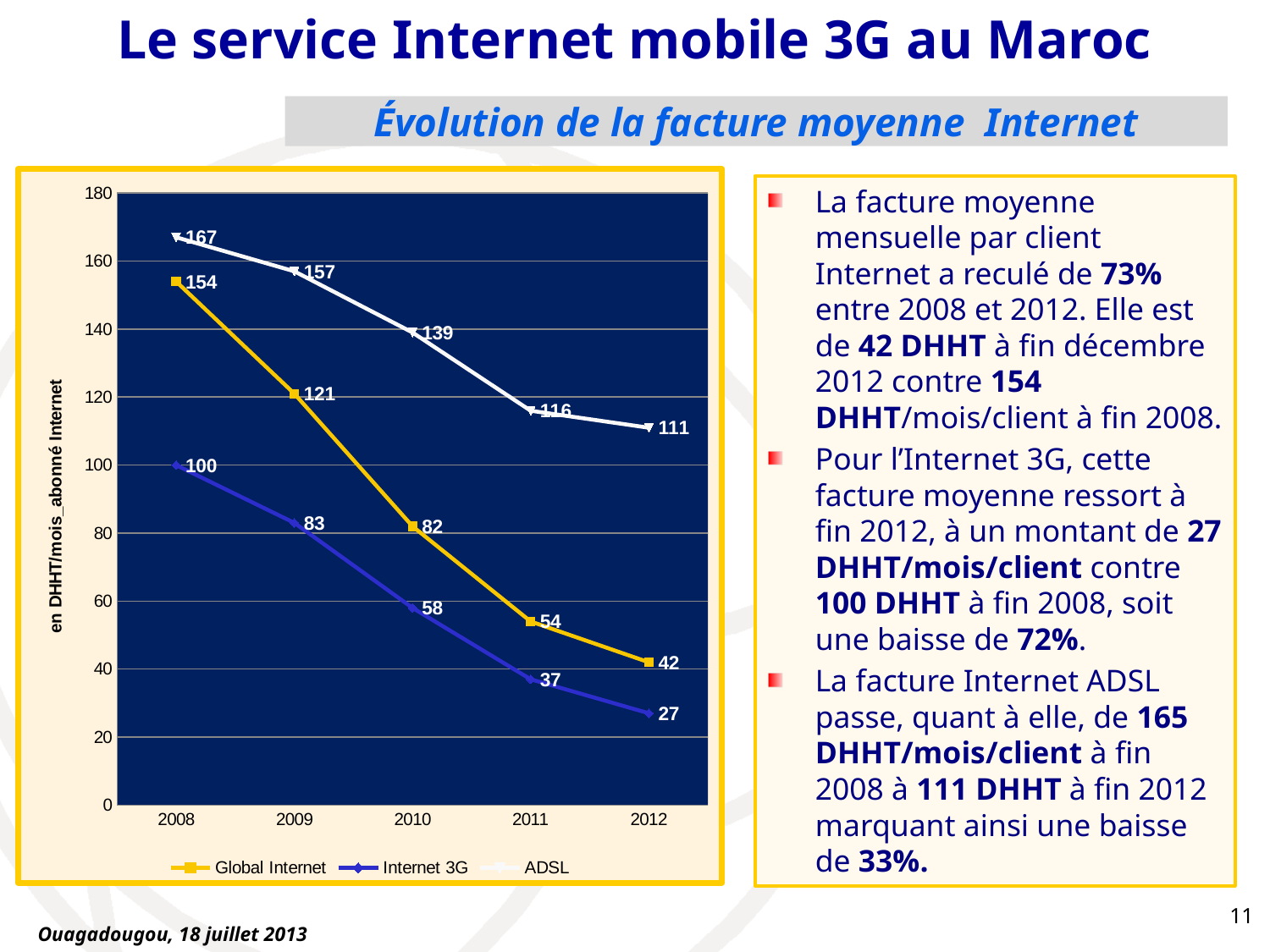
How many years are shown on the x axis? 5 In which year is the Global Internet value lowest? 2012 What is the label of the y axis? en DHHT/mois_abonné Internet How many series does the legend list? 3 What is the value for Internet 3G in 2012? 27 What is the value for Global Internet in 2008? 154 What is the value for ADSL in 2010? 139 What is the difference between the ADSL value and the Internet 3G value in 2011? 79 In which year is the ADSL value highest? 2008 Do the Internet 3G values rise or fall from 2008 to 2012? Fall Which is larger in 2009: the Global Internet value or the Internet 3G value? Global Internet What type of chart is shown on the slide? Line chart